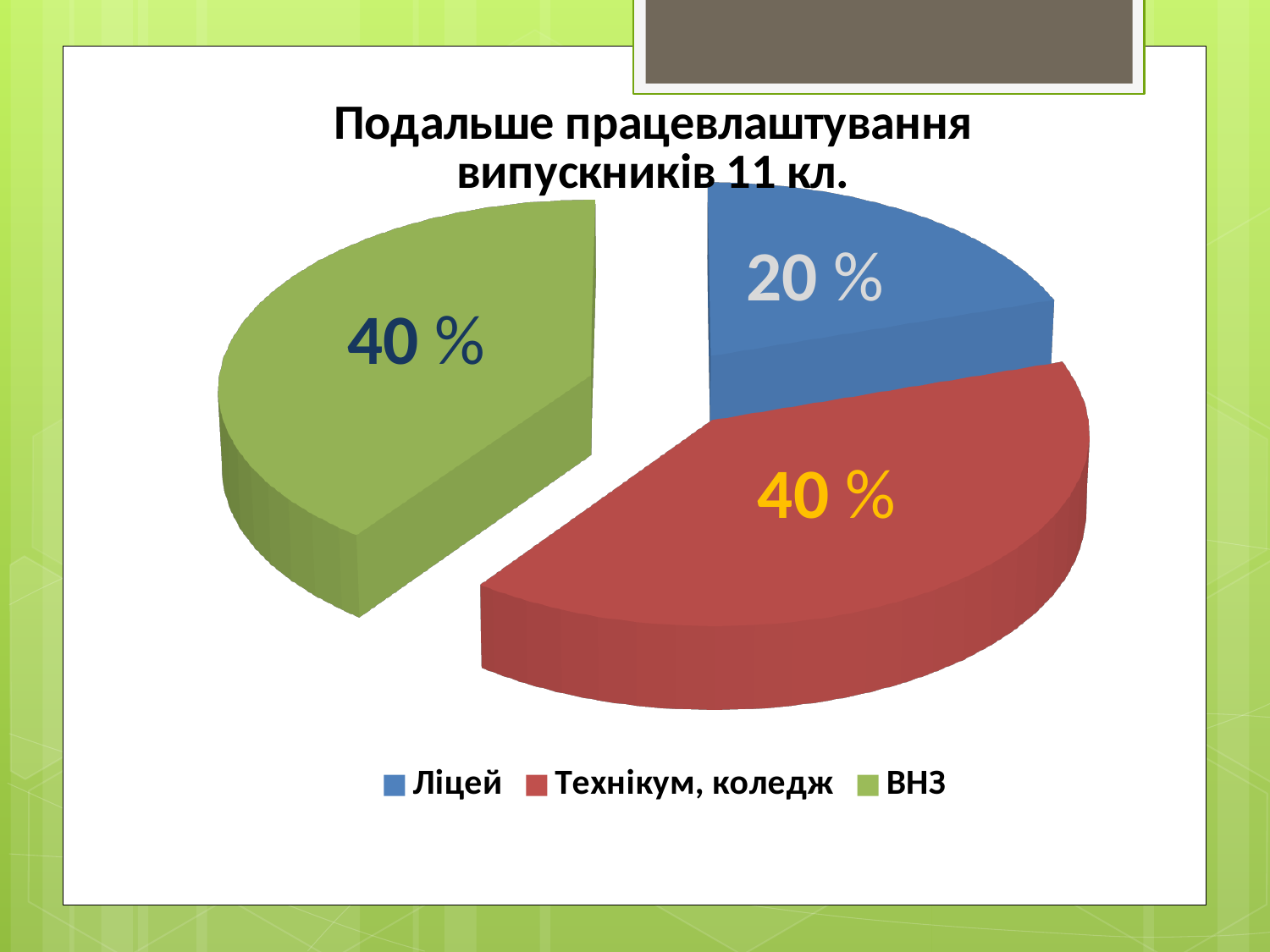
How many slices does the pie chart have? 3 What share of the pie does Ліцей represent? 20 % What is the difference between the values for Технікум, коледж and Ліцей? 20 % What kind of chart is shown on the slide? pie chart What colour is the slice for ВНЗ? green Which is larger, the slice for Ліцей or the slice for ВНЗ? ВНЗ Which category has the smallest slice of the pie? Ліцей What is the title of the chart? Подальше працевлаштування випускників 11 кл. What is the value shown for Ліцей? 20 % What is the value shown for Технікум, коледж? 40 % How many entries does the legend list? 3 What is the value shown for ВНЗ? 40 %